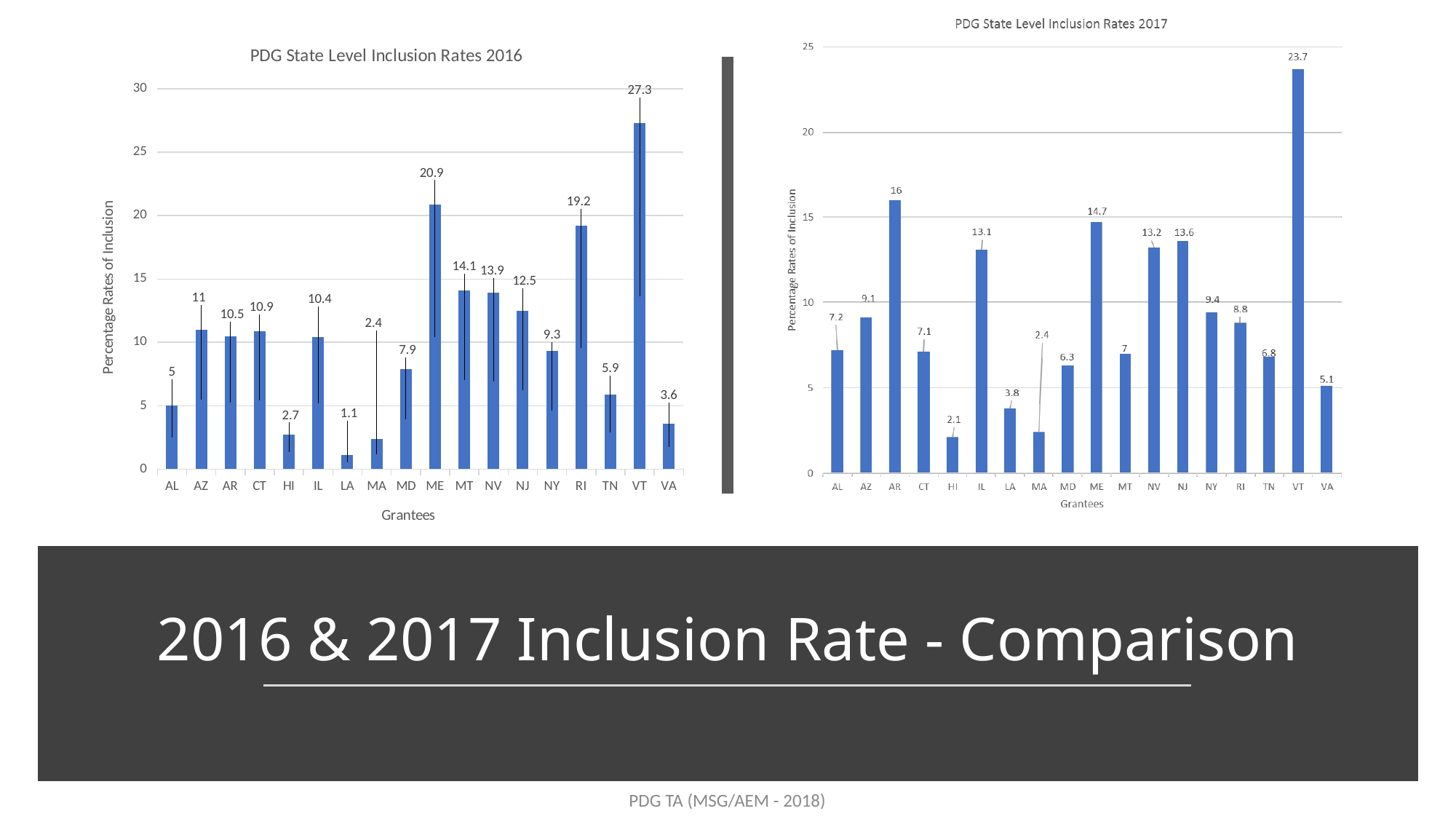
In the 'PDG State Level Inclusion Rates 2016' chart, which is larger, the value for RI or the value for NJ? RI In the 'PDG State Level Inclusion Rates 2016' chart, what is the value for VT? 27.3 In the 'PDG State Level Inclusion Rates 2017' chart, which grantee has the highest value? VT In the 'PDG State Level Inclusion Rates 2017' chart, what is the value for AR? 16 How many grantees are shown on the x axis of the 'PDG State Level Inclusion Rates 2016' chart? 18 What is the y-axis label of the 'PDG State Level Inclusion Rates 2016' chart? Percentage Rates of Inclusion In the 'PDG State Level Inclusion Rates 2017' chart, what is the difference between the values for VT and ME? 9 In the 'PDG State Level Inclusion Rates 2017' chart, which grantee has the lowest value? HI In the 'PDG State Level Inclusion Rates 2017' chart, is the value for IL greater or less than 10? greater In the 'PDG State Level Inclusion Rates 2016' chart, which grantee has the lowest value? LA In the 'PDG State Level Inclusion Rates 2016' chart, what is the difference between the values for ME and MD? 13 What kind of chart is the 'PDG State Level Inclusion Rates 2017' chart? bar chart